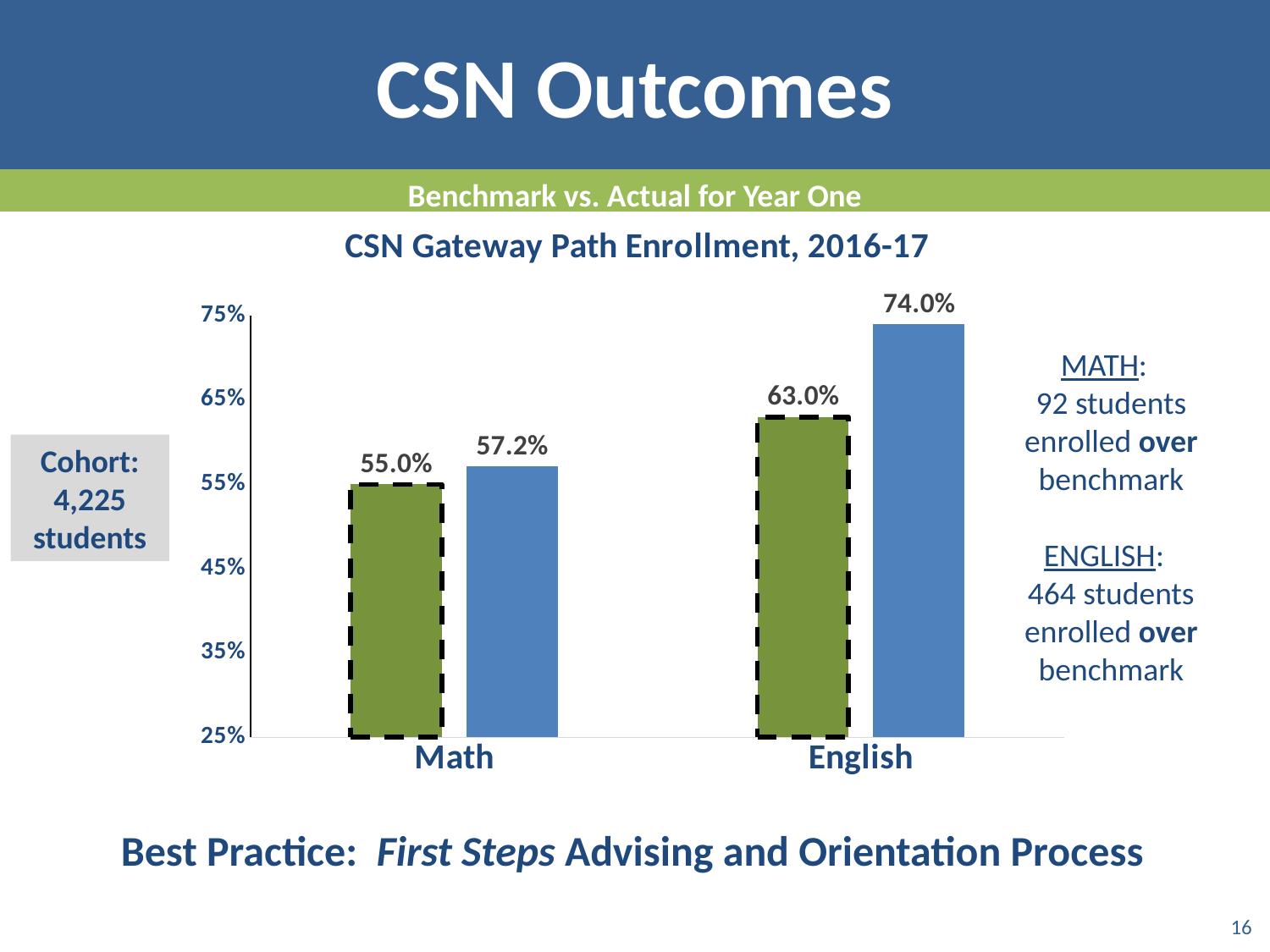
What is the value of the green bar for English in the CSN Gateway Path Enrollment chart? 63.0% What is the title of the chart on the slide? CSN Gateway Path Enrollment, 2016-17 Which bar has the lowest value in the CSN Gateway Path Enrollment chart? Math green bar (55.0%) Is the blue bar for English larger or smaller than the blue bar for Math in the CSN Gateway Path Enrollment chart? larger Which bar has the highest value in the CSN Gateway Path Enrollment chart? English blue bar (74.0%) What is the difference between the blue and green bars for Math in the CSN Gateway Path Enrollment chart? 2.2% What is the value of the green bar for Math in the CSN Gateway Path Enrollment chart? 55.0% What type of chart is the CSN Gateway Path Enrollment chart? bar chart What is the value of the blue bar for English in the CSN Gateway Path Enrollment chart? 74.0% What is the difference between the blue and green bars for English in the CSN Gateway Path Enrollment chart? 11.0% What is the value of the blue bar for Math in the CSN Gateway Path Enrollment chart? 57.2% How many categories are shown on the x axis of the CSN Gateway Path Enrollment chart? 2